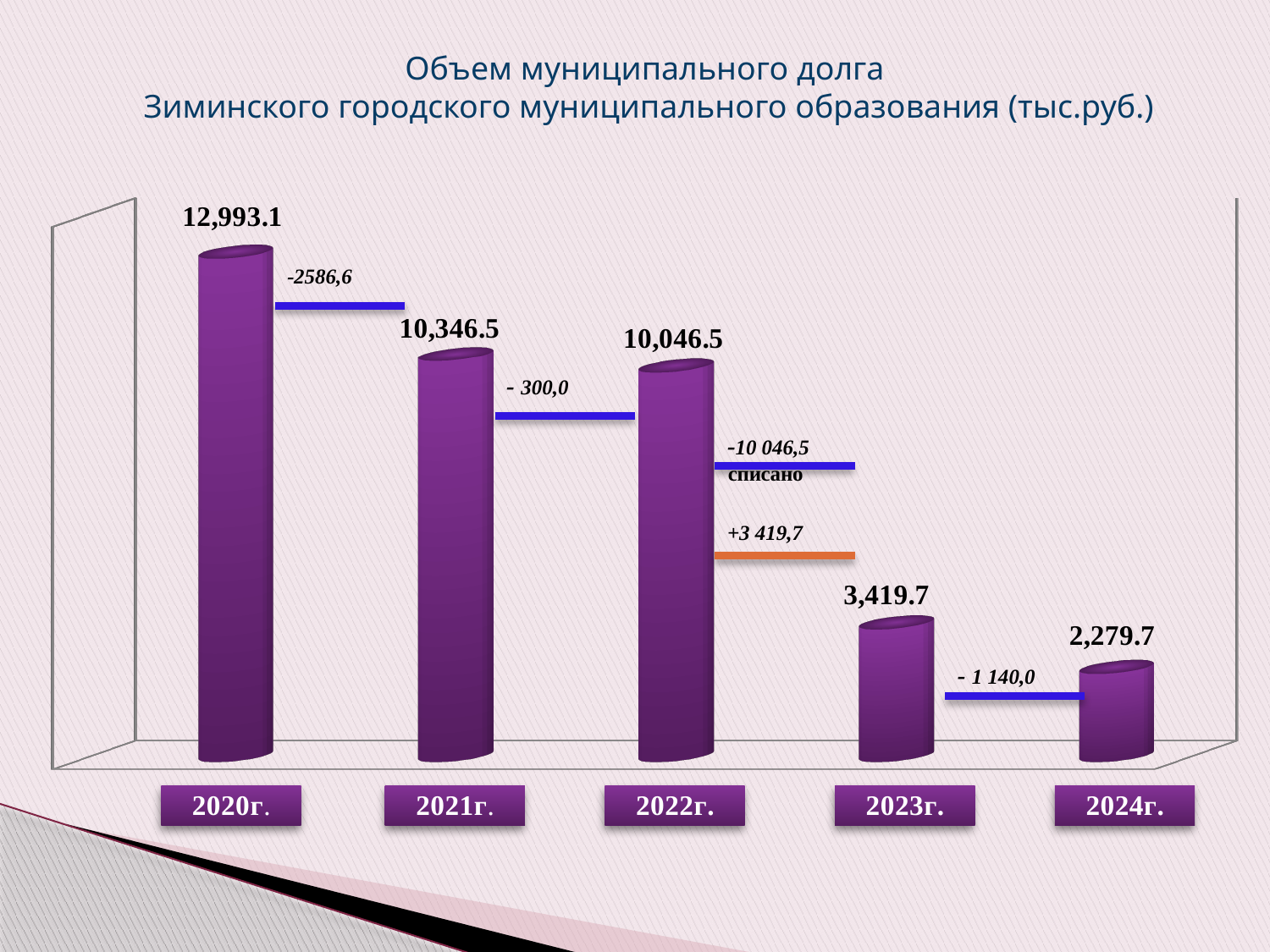
Which is larger, the value for 2021г. or the value for 2023г.? 2021г. What is the difference between the values for 2023г. and 2024г.? 1,140.0 What is the value for 2020г.? 12,993.1 Which year has the lowest value? 2024г. What is the unit given in the chart title? тыс.руб. How many years are shown on the chart? 5 What is the value for 2022г.? 10,046.5 What is the value for 2024г.? 2,279.7 What is the difference between the values for 2021г. and 2022г.? 300.0 Do the values rise or fall from 2020г. to 2024г.? Fall What kind of chart is this? Bar chart Which year has the highest value? 2020г.